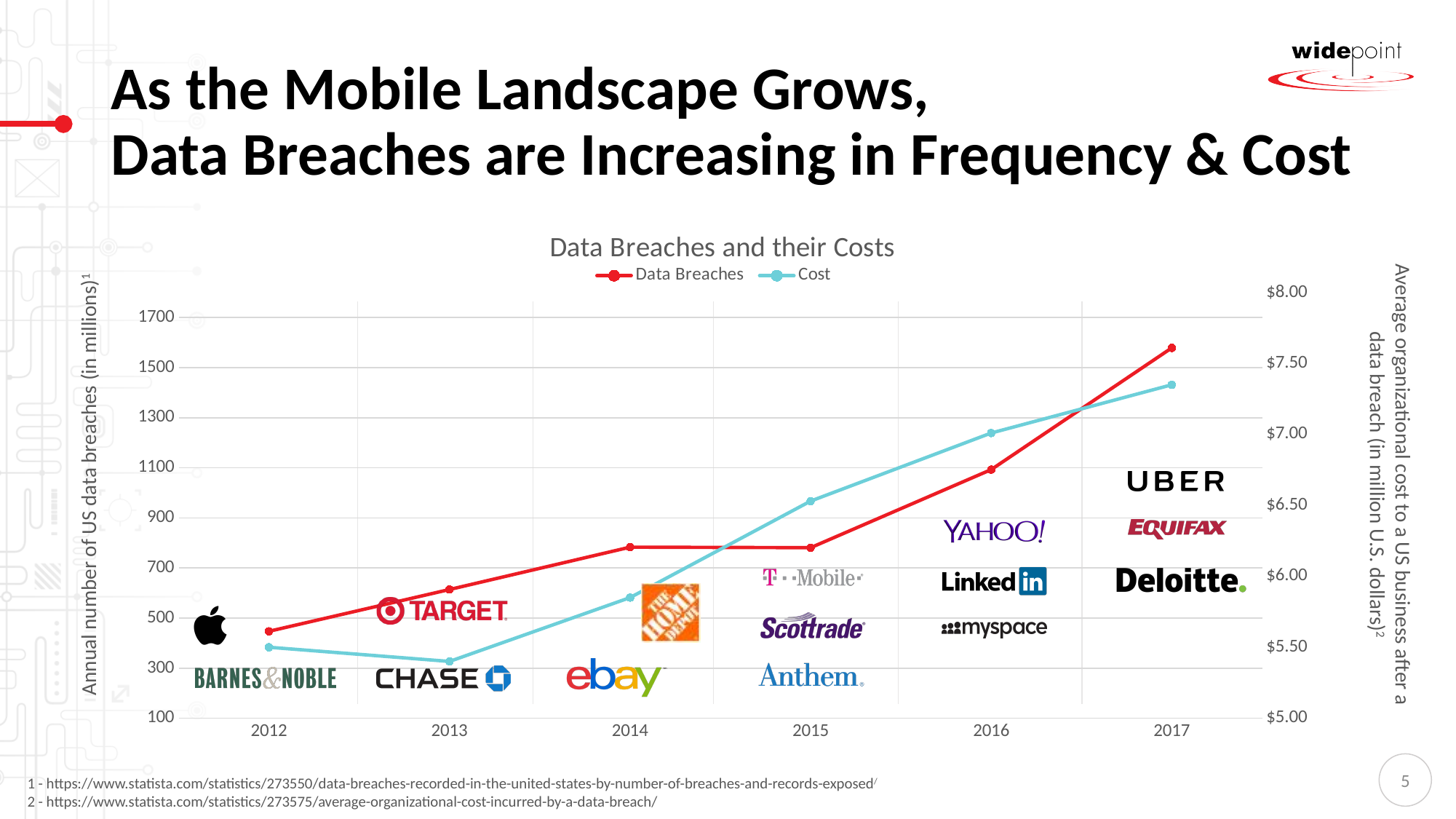
Is the Data Breaches value for 2012 greater or less than 500? less In which year is the Data Breaches series at its lowest? 2012 What is the title of the chart? Data Breaches and their Costs In which year is the Data Breaches series at its highest? 2017 Is the Data Breaches value for 2017 greater or less than 1500? greater How many years are plotted along the x axis? 6 How many series does the chart legend list? 2 In which year is the Cost series at its highest? 2017 What type of chart is shown on the slide? line chart Is the Cost value for 2017 greater or less than $7.50? less Which year has the larger Data Breaches value, 2013 or 2016? 2016 Does the Data Breaches series generally rise or fall from 2012 to 2017? rise